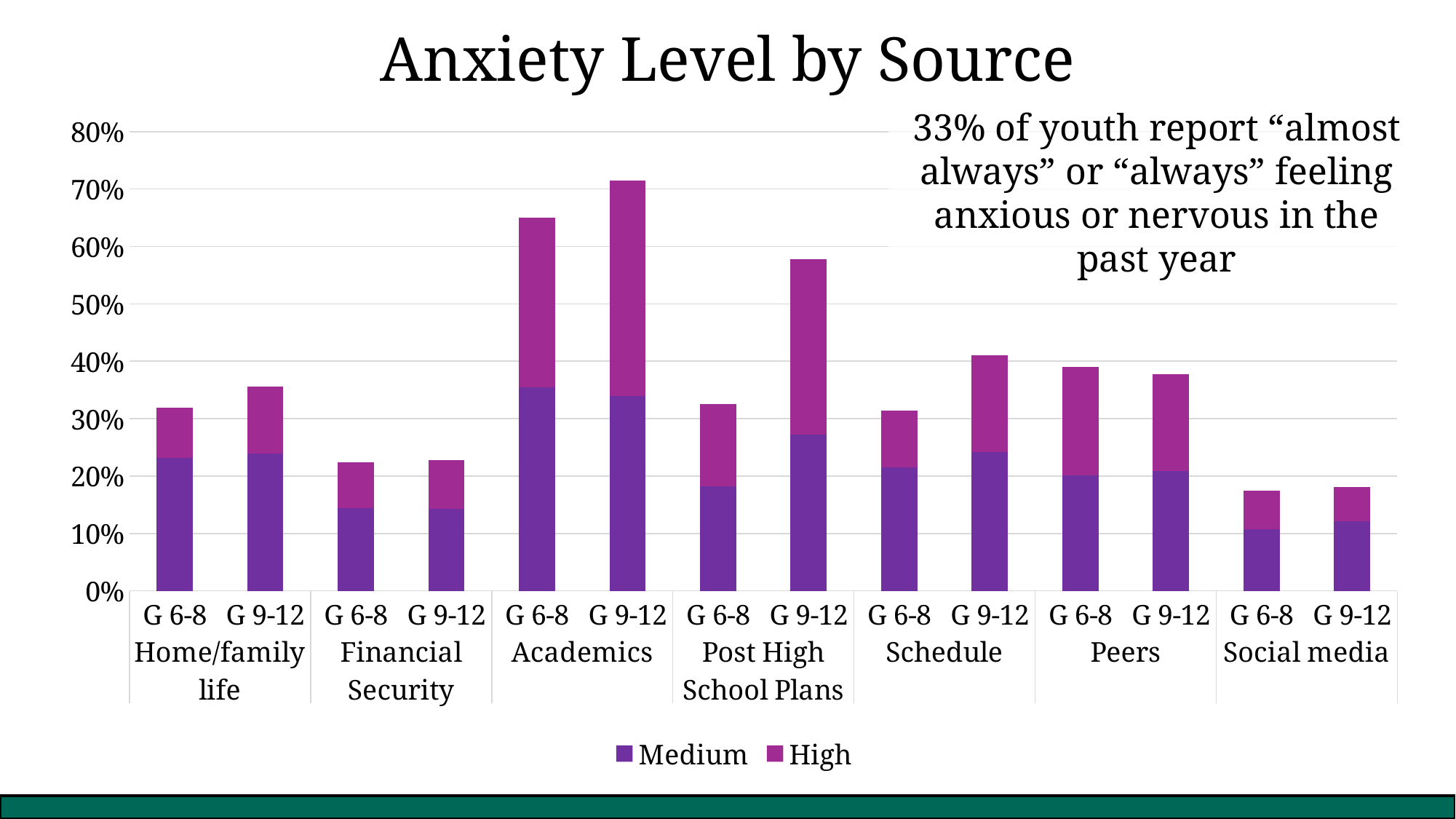
What kind of chart is shown on the slide? Stacked bar chart How many bars are plotted in total? 14 Is the total value for Academics G 6-8 greater or less than 60%? greater Is the total value for Post High School Plans G 9-12 greater or less than 60%? less What is the title of the chart? Anxiety Level by Source Is the total value for Social media G 6-8 greater or less than 20%? less Which is larger, the total for Post High School Plans G 6-8 or Post High School Plans G 9-12? Post High School Plans G 9-12 How many series does the legend list? 2 How many anxiety sources are shown along the x axis? 7 Which source has the lowest bars overall? Social media Which bar has the highest total anxiety level? Academics G 9-12 According to the text on the slide, what percentage of youth report "almost always" or "always" feeling anxious or nervous in the past year? 33%